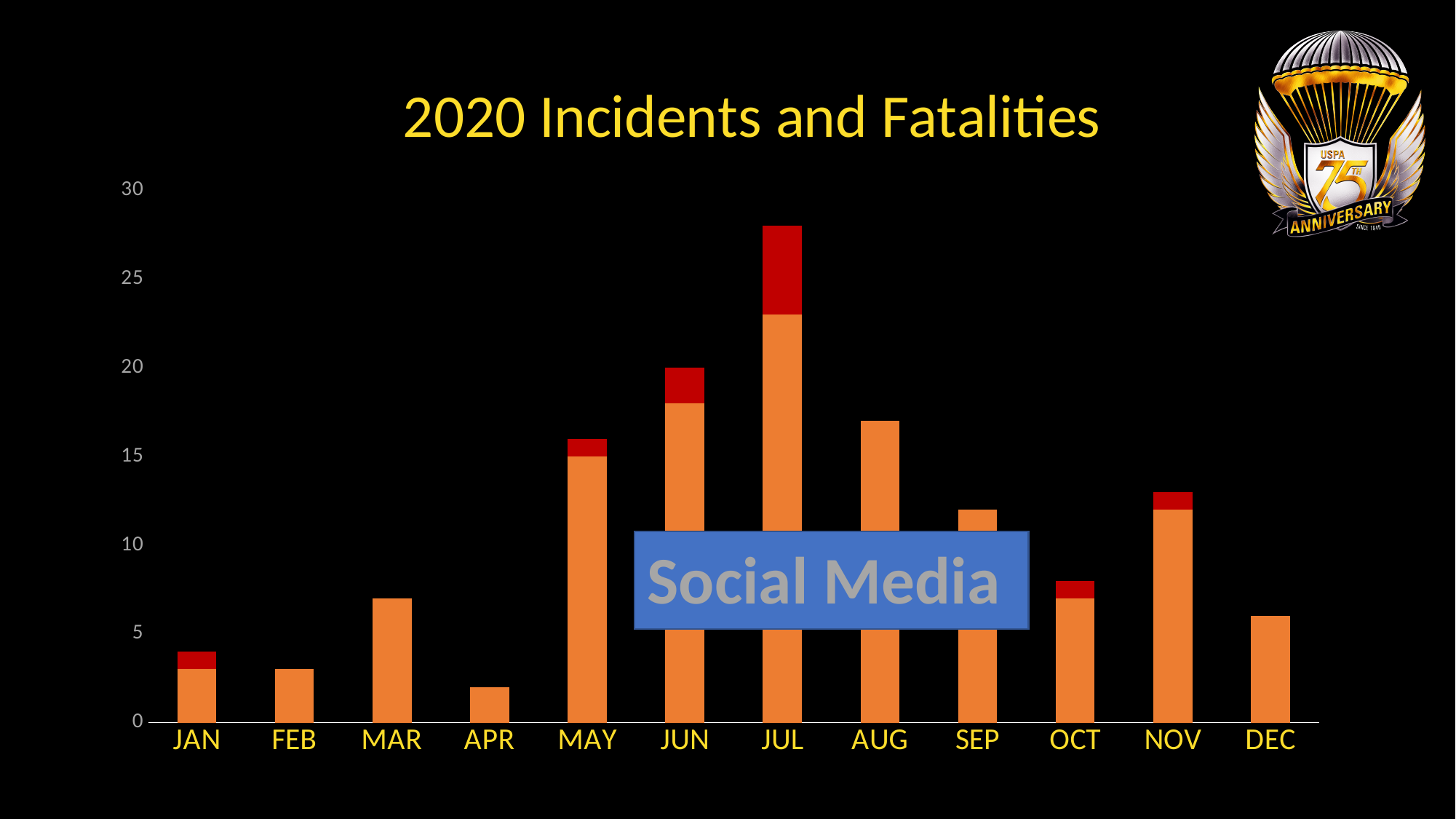
Is the total value for APR greater or less than 5? less What is the title of the chart? 2020 Incidents and Fatalities Do the bar heights rise or fall from APR to JUL? rise What kind of chart is shown on the slide? bar chart Is the total value for OCT greater or less than 10? less Which month has a taller bar, JUN or AUG? JUN Is the total value for AUG greater or less than 15? greater What text appears in the blue box overlaid on the chart? Social Media Which month has the tallest bar in the chart? JUL How many months are shown along the x axis of the chart? 12 Which month has the shortest bar in the chart? APR